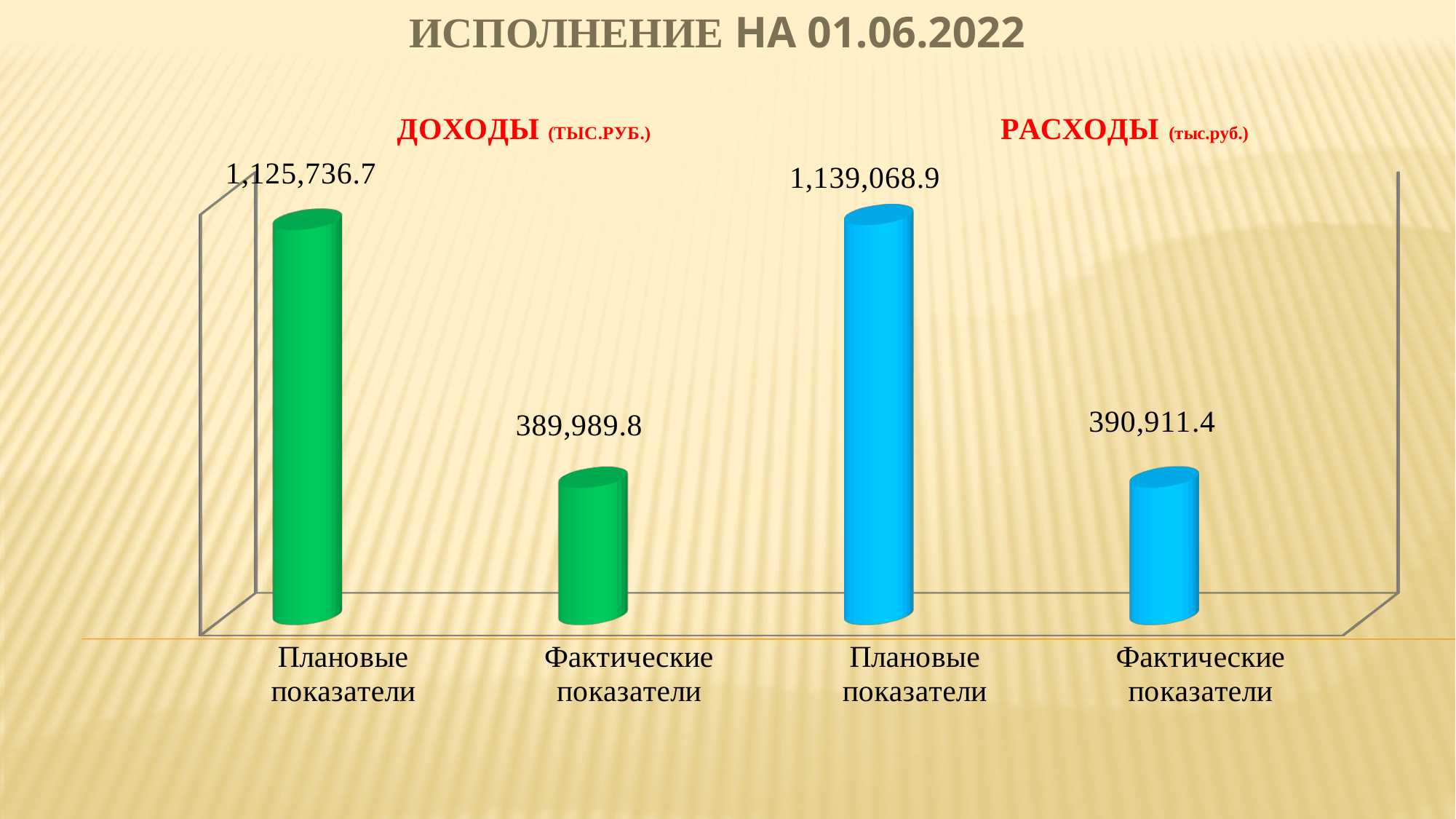
In what units are the values on the chart given? тыс.руб. What is the value of Плановые показатели under РАСХОДЫ? 1,139,068.9 What is the difference between Плановые показатели and Фактические показатели under ДОХОДЫ? 735,746.9 What is the value of Фактические показатели under ДОХОДЫ? 389,989.8 What is the difference between Плановые показатели and Фактические показатели under РАСХОДЫ? 748,157.5 Which bar has the highest value on the chart? Плановые показатели (РАСХОДЫ), 1,139,068.9 What is the value of Фактические показатели under РАСХОДЫ? 390,911.4 How many bars are plotted on the chart? 4 Which bar has the lowest value on the chart? Фактические показатели (ДОХОДЫ), 389,989.8 Which is larger: Плановые показатели under ДОХОДЫ or Плановые показатели under РАСХОДЫ? Плановые показатели under РАСХОДЫ What is the value of Плановые показатели under ДОХОДЫ? 1,125,736.7 What kind of chart is shown on the slide? bar chart